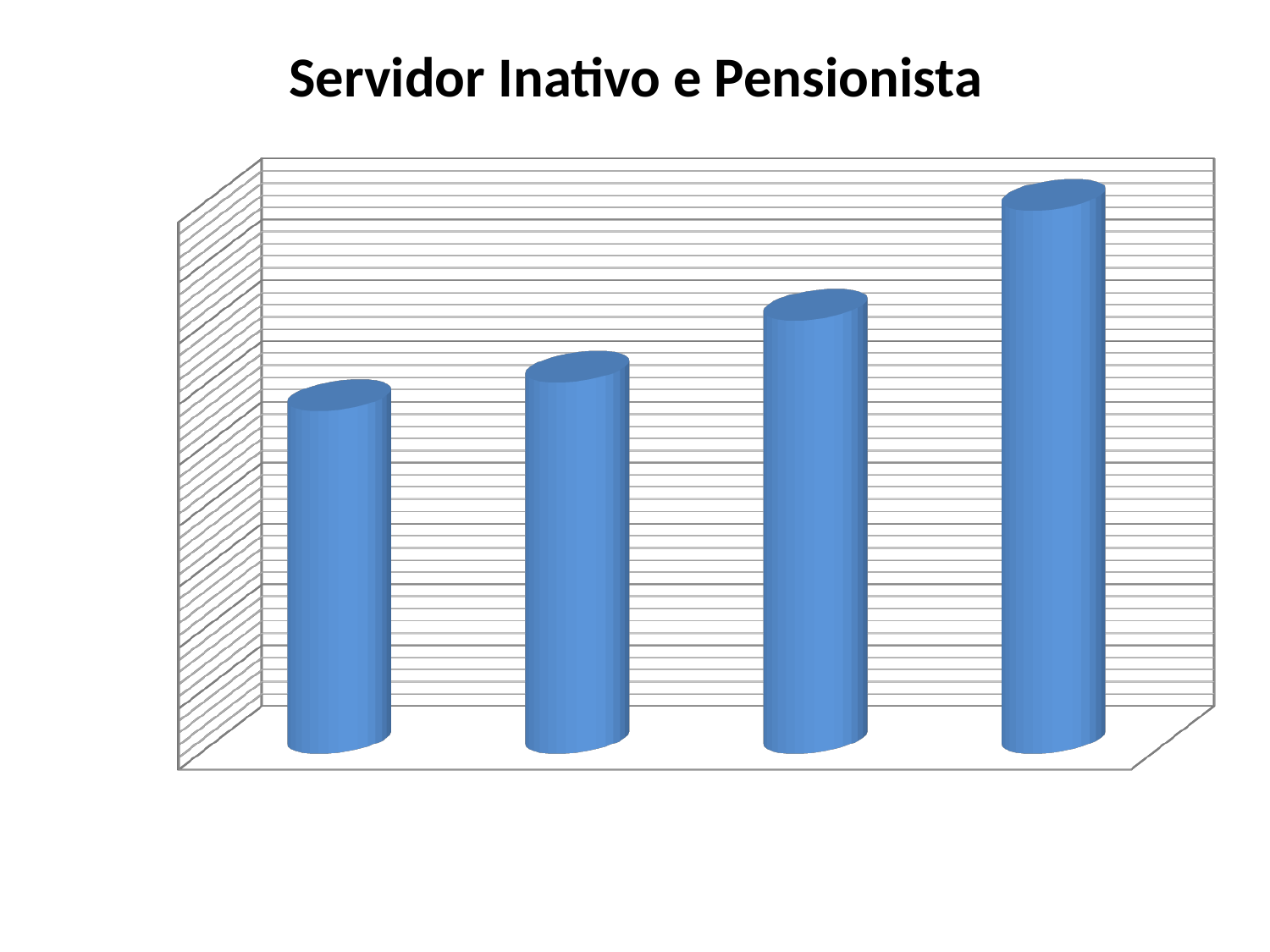
Which bar is the shortest in the chart, counting from the left? the first bar Which bar is the tallest in the chart, counting from the left? the fourth bar Do the bar values rise or fall from left to right across the chart? rise Which is larger, the second bar or the third bar from the left? the third bar Which is larger, the first bar or the fourth bar from the left? the fourth bar What is the title of the chart? Servidor Inativo e Pensionista What colour are the bars in the chart? blue What kind of chart is shown on the slide? bar chart How many bars are plotted in the chart? 4